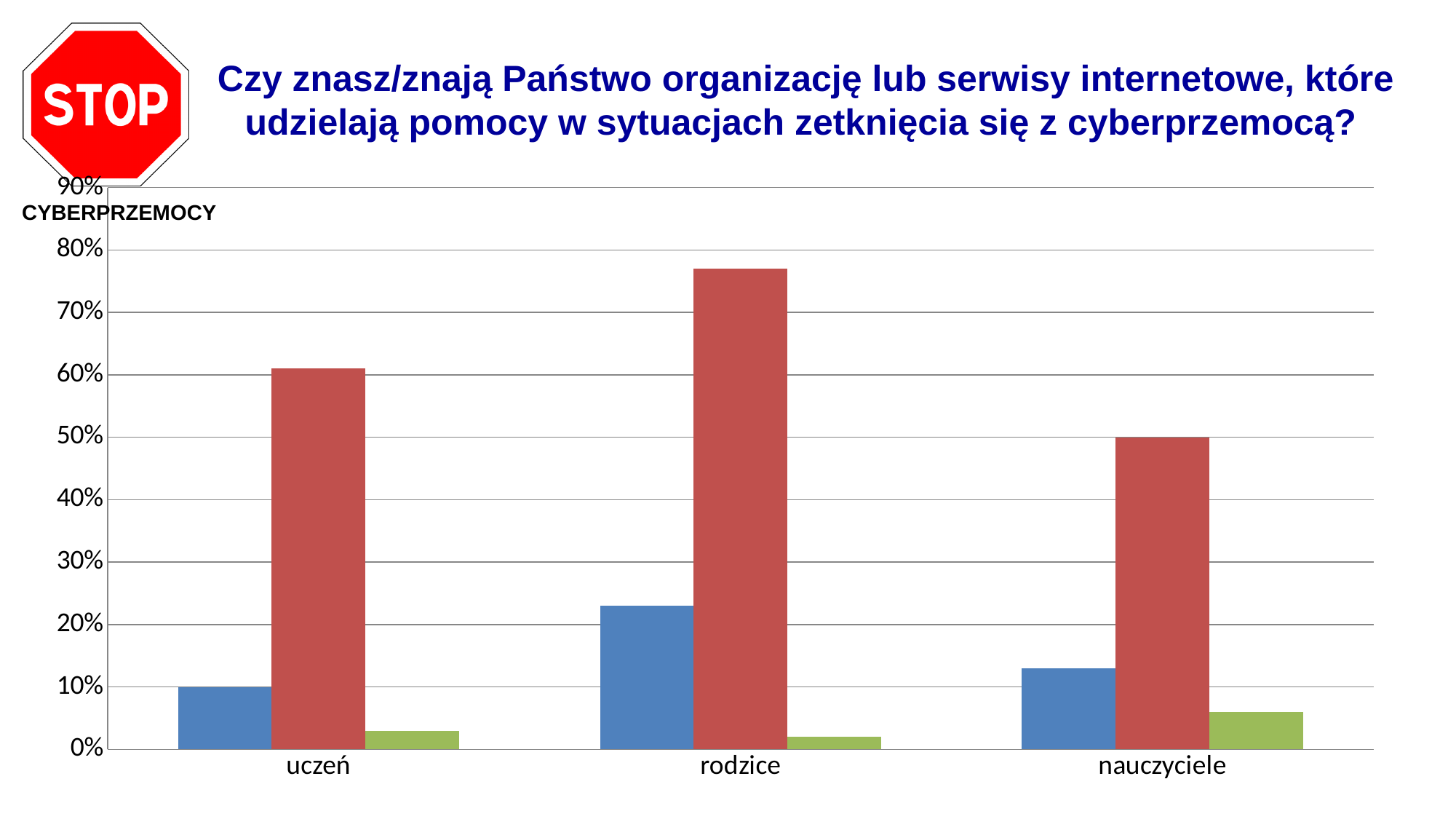
How many bars are plotted for each category in the chart? 3 Is the green bar for uczeń greater or less than 10%? less What kind of chart is shown on the slide? bar chart Which category has the tallest red bar? rodzice How many categories are shown on the x axis of the chart? 3 Which category has the tallest green bar? nauczyciele Is the blue bar for rodzice greater or less than 20%? greater Which is larger, the red bar for uczeń or the red bar for nauczyciele? uczeń Which category has the shortest red bar? nauczyciele Which category has the shortest blue bar? uczeń Which category has the tallest blue bar? rodzice Is the red bar for rodzice greater or less than 70%? greater